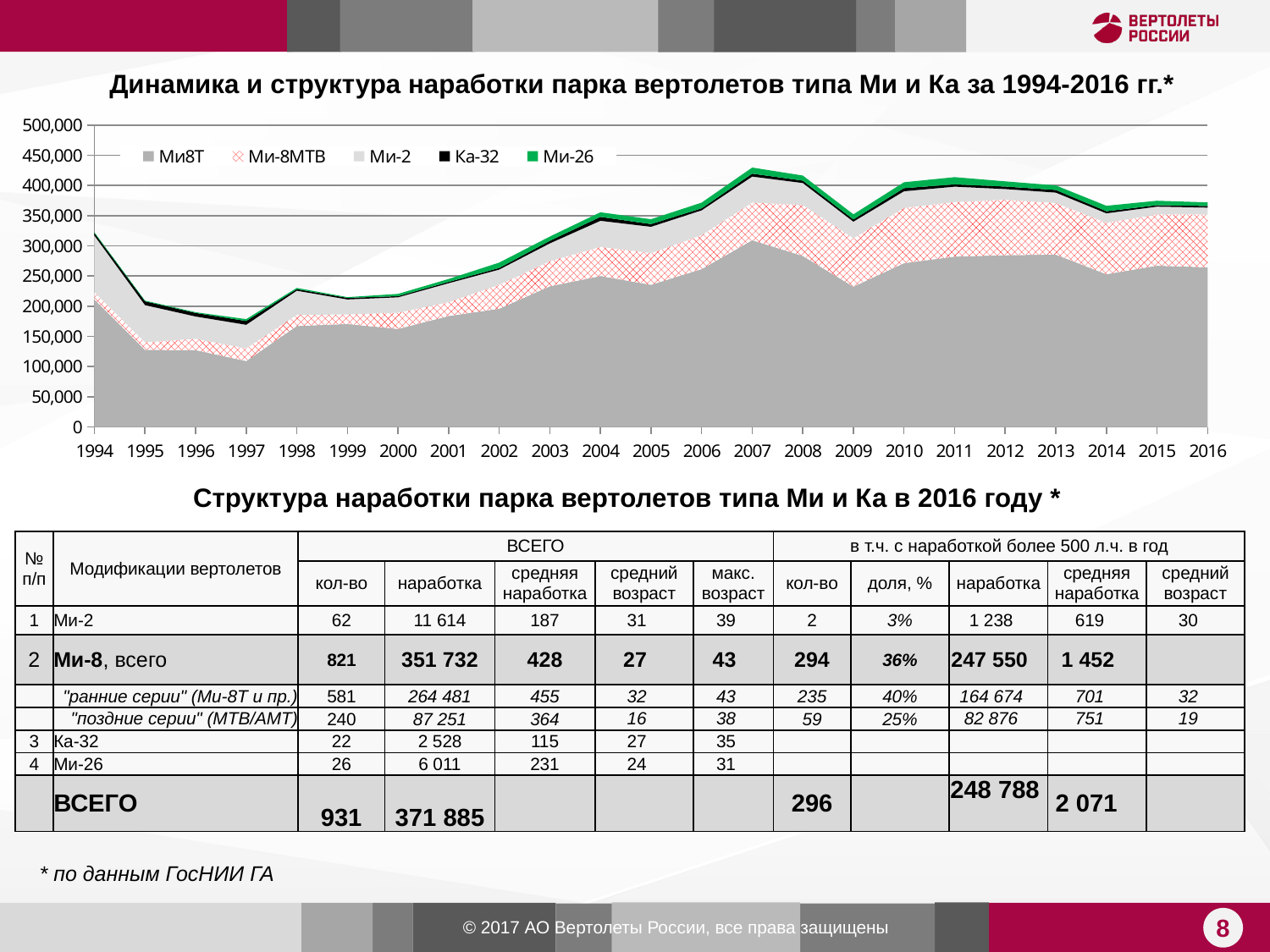
Which series is shown in green in the chart? Ми-26 Is the total stacked value for 2007 greater or less than 400,000? greater Is the total stacked value for 1997 greater or less than 200,000? less What kind of chart is shown on the slide? stacked area chart How many series does the chart legend list? 5 How many years are shown along the x axis of the chart? 23 In which year is the total stacked value at its lowest? 1997 In which year does the total stacked value reach its highest point? 2007 Is the total stacked value for 2016 greater or less than 350,000? greater Does the total stacked value rise or fall from 1994 to 1997? fall Which year has the larger total stacked value, 2007 or 2016? 2007